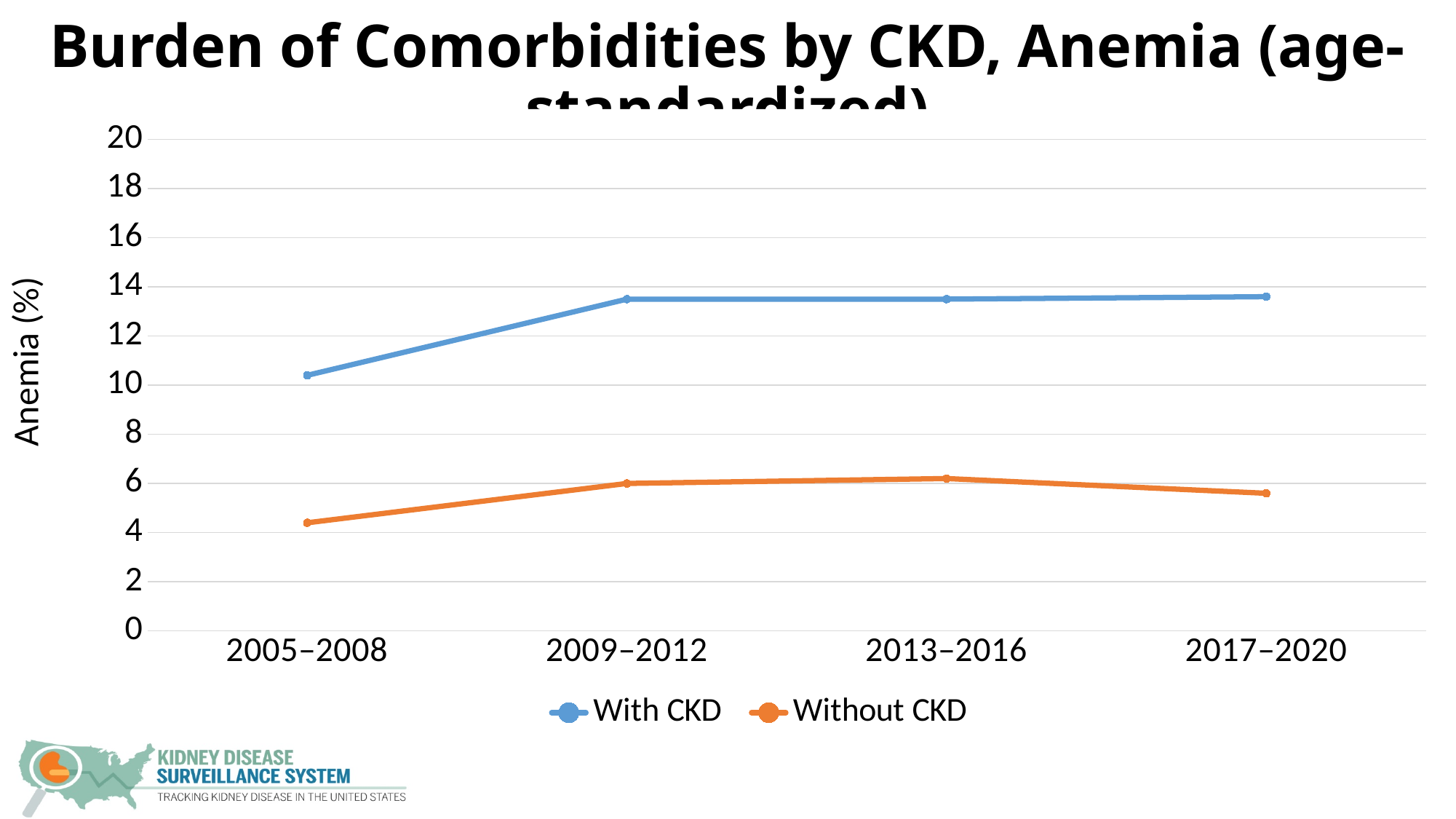
Is the Without CKD value for 2005–2008 greater or less than 6? less In which period is the With CKD value lowest? 2005–2008 How many time periods are shown on the x axis? 4 What kind of chart is shown on the slide? line chart Does the With CKD line rise or fall from 2005–2008 to 2009–2012? rise Is the With CKD value for 2009–2012 greater or less than 12? greater Which series has the higher value in 2017–2020, With CKD or Without CKD? With CKD In which period is the Without CKD value lowest? 2005–2008 Is the With CKD value for 2005–2008 greater or less than 12? less How many series does the legend list? 2 What is the label of the y axis? Anemia (%) Which series is plotted in orange? Without CKD